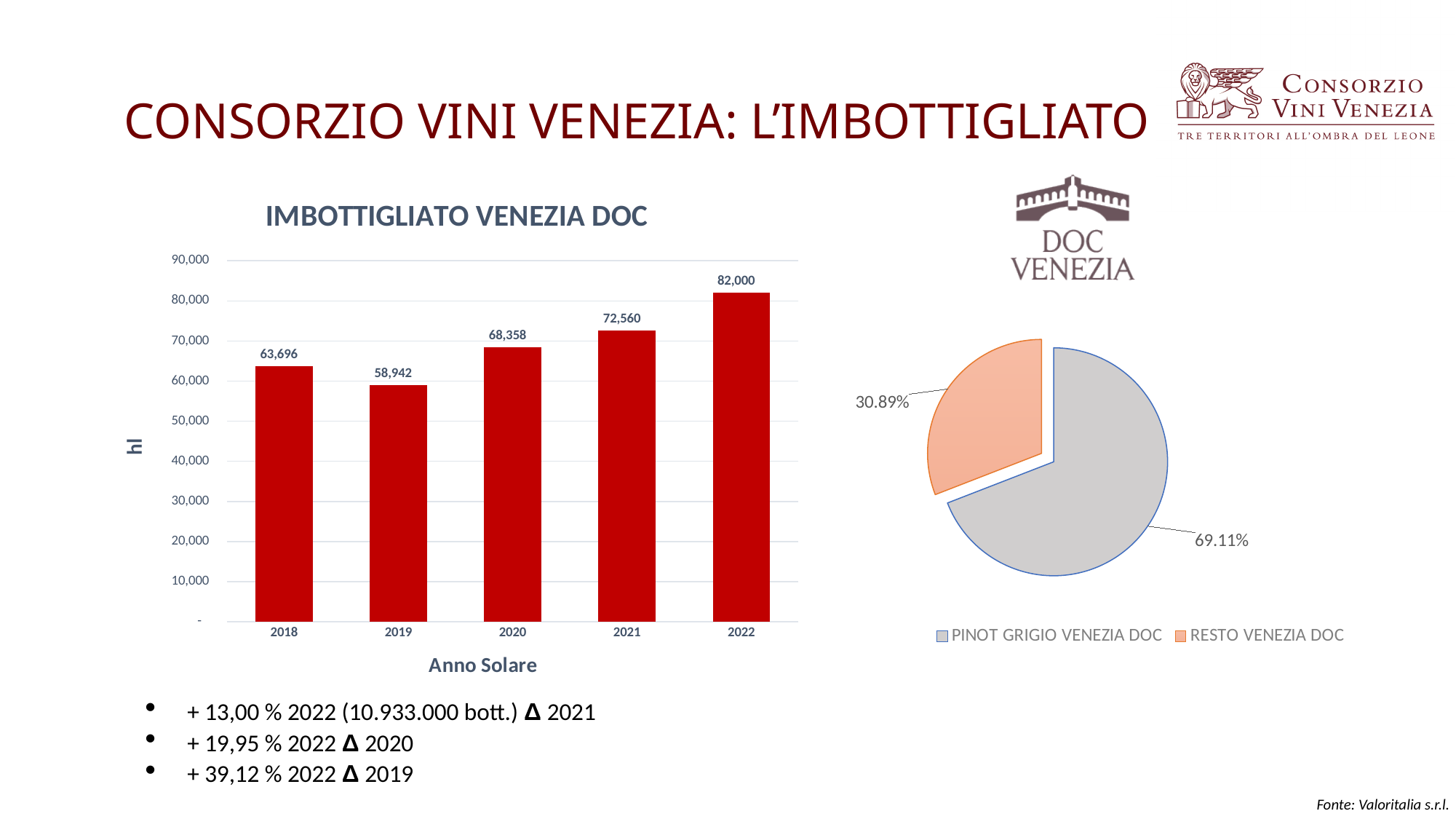
In the bar chart titled IMBOTTIGLIATO VENEZIA DOC, which year has the lowest value? 2019 In the bar chart titled IMBOTTIGLIATO VENEZIA DOC, what is the value for 2022? 82,000 In the bar chart titled IMBOTTIGLIATO VENEZIA DOC, which year has the highest value? 2022 In the bar chart titled IMBOTTIGLIATO VENEZIA DOC, what is the label of the y axis? hl In the bar chart titled IMBOTTIGLIATO VENEZIA DOC, how many years are shown on the x axis? 5 In the bar chart titled IMBOTTIGLIATO VENEZIA DOC, do the values rise or fall from 2019 to 2022? rise In the pie chart on the right, what share does PINOT GRIGIO VENEZIA DOC have? 69.11% In the bar chart titled IMBOTTIGLIATO VENEZIA DOC, what is the value for 2019? 58,942 In the bar chart titled IMBOTTIGLIATO VENEZIA DOC, which is larger, the value for 2018 or the value for 2020? 2020 In the bar chart titled IMBOTTIGLIATO VENEZIA DOC, what is the difference between the 2022 and 2021 values? 9,440 In the pie chart on the right, what share does RESTO VENEZIA DOC have? 30.89% What kind of chart is the IMBOTTIGLIATO VENEZIA DOC chart on the left? bar chart